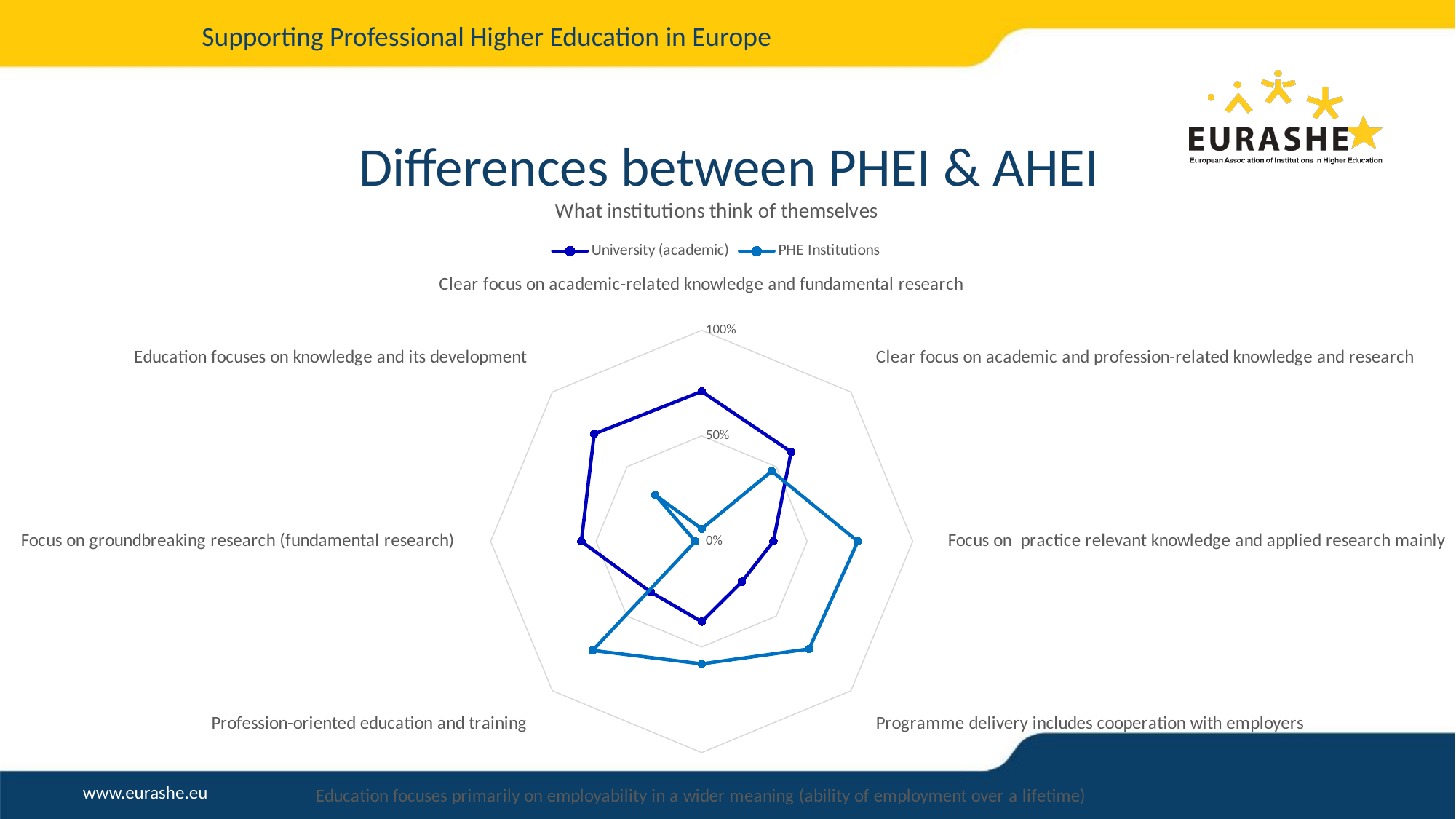
How many series does the chart legend list? 2 What is the highest value shown on the chart's axis scale? 100% How many categories (axes) does the radar chart have? 8 Which series has the higher value for 'Focus on groundbreaking research (fundamental research)'? University (academic) What kind of chart is shown on the slide? Radar chart Is the PHE Institutions value for 'Focus on practice relevant knowledge and applied research mainly' greater or less than 50%? greater Is the PHE Institutions value for 'Clear focus on academic-related knowledge and fundamental research' greater or less than 50%? less What is the title of the chart? What institutions think of themselves Is the University (academic) value for 'Clear focus on academic-related knowledge and fundamental research' greater or less than 50%? greater Which series has the higher value for 'Programme delivery includes cooperation with employers'? PHE Institutions